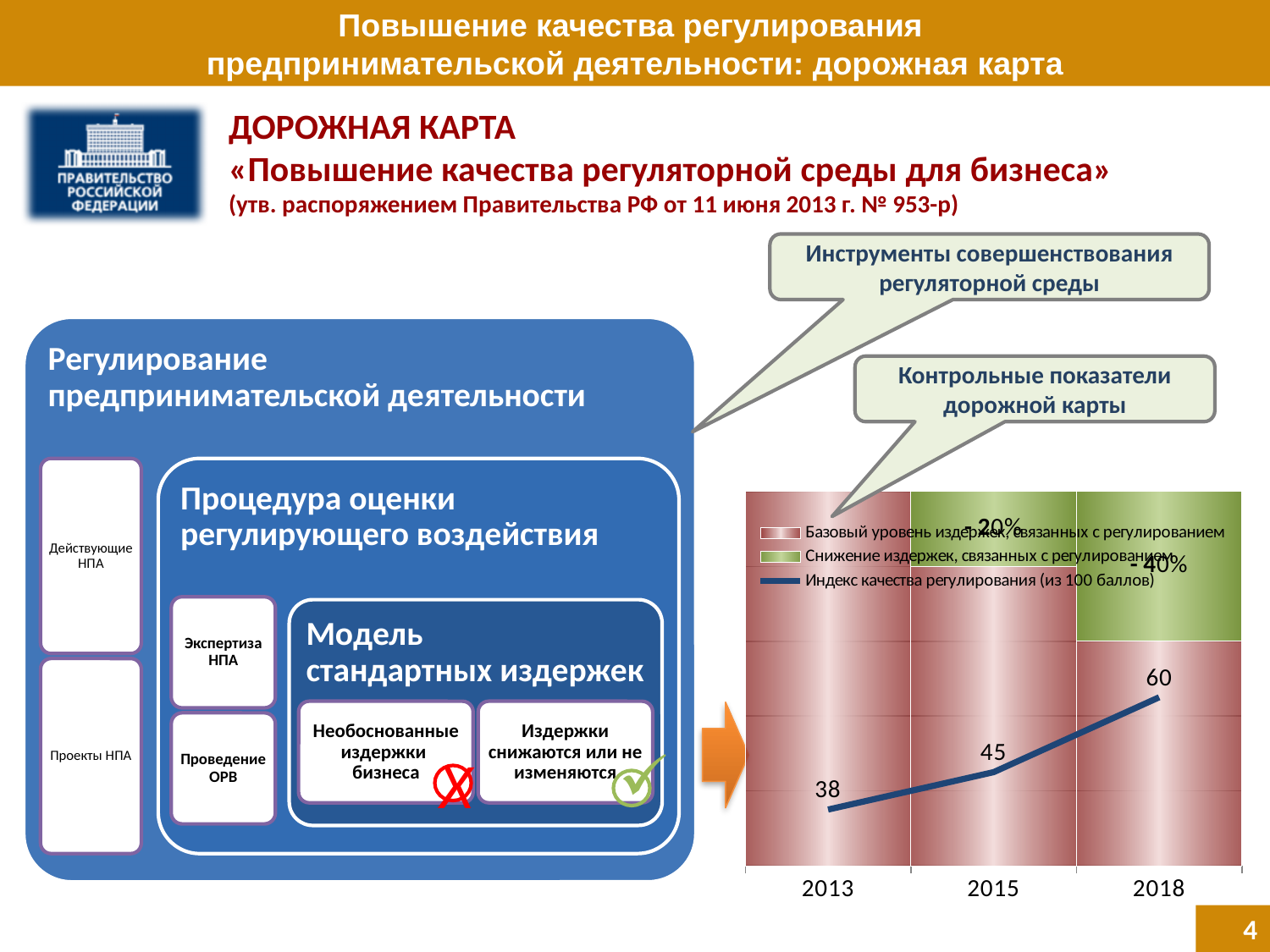
Which year has the highest regulation quality index value? 2018 How many series does the chart legend list? 3 Which year has the lowest regulation quality index value? 2013 By how much does the regulation quality index increase from 2015 to 2018? 15 What is the value of the regulation quality index (Индекс качества регулирования) for 2015? 45 What is the value of the regulation quality index (Индекс качества регулирования) for 2013? 38 What reduction in regulation-related costs is labelled for 2015? - 20% By how much does the regulation quality index increase from 2013 to 2018? 22 Is the regulation quality index higher in 2015 or in 2013? 2015 What is the value of the regulation quality index (Индекс качества регулирования) for 2018? 60 What reduction in regulation-related costs is labelled for 2018? - 40% How many years are shown on the x axis of the chart? 3